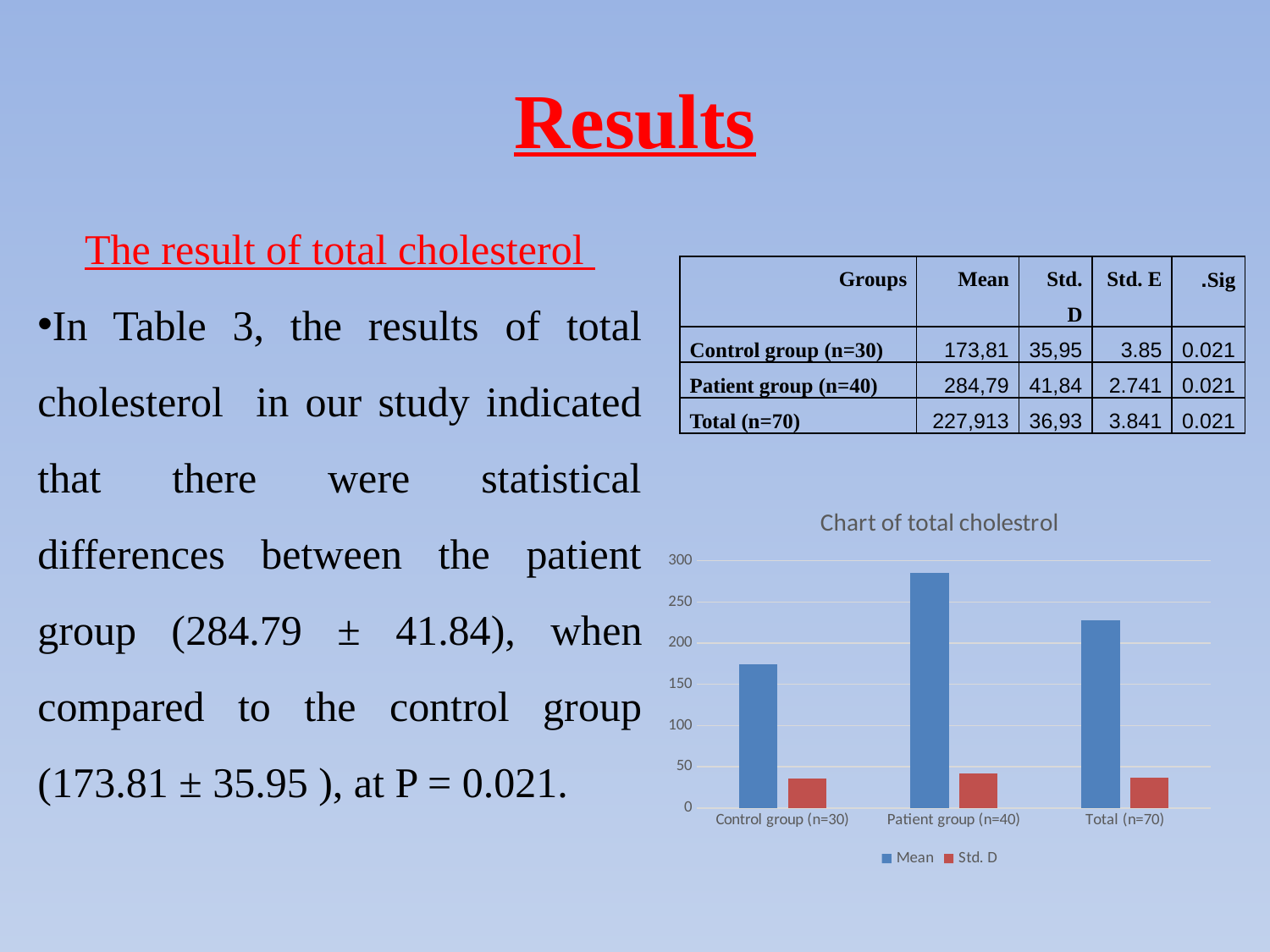
Which group has the highest Mean bar in the chart? Patient group (n=40) Which group has the lowest Mean bar in the chart? Control group (n=30) What kind of chart is shown on the slide? bar chart Is the Mean bar for Patient group (n=40) greater or less than 250? greater Is the Std. D bar for Patient group (n=40) greater or less than 50? less Is the Mean bar for Total (n=70) greater or less than 250? less What is the title of the chart? Chart of total cholestrol How many series does the chart legend list? 2 How many groups are shown on the x axis of the chart? 3 Which is larger in the chart: the Mean for Total (n=70) or the Mean for Control group (n=30)? Total (n=70)